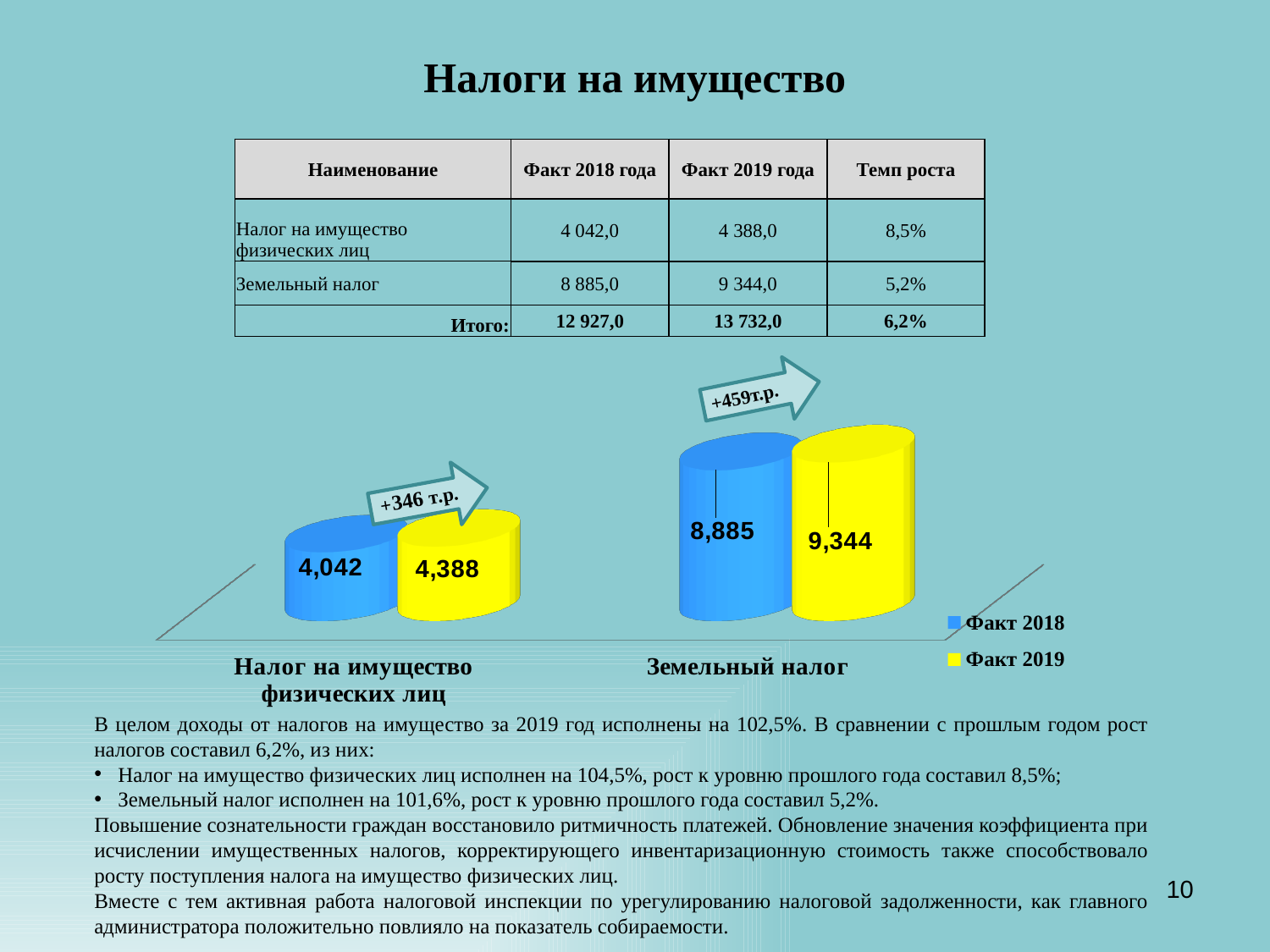
What is the difference between the Факт 2019 and Факт 2018 values for Налог на имущество физических лиц in the chart? 346 In the chart, which is larger for Земельный налог: the Факт 2018 value or the Факт 2019 value? Факт 2019 What is the value for Факт 2019 for Налог на имущество физических лиц in the chart? 4,388 What kind of chart is shown on the slide? Bar chart Which category has the highest Факт 2019 value in the chart? Земельный налог How many categories are shown on the x axis of the chart? 2 What is the value for Факт 2019 for Земельный налог in the chart? 9,344 Which category has the lowest Факт 2018 value in the chart? Налог на имущество физических лиц What is the value for Факт 2018 for Налог на имущество физических лиц in the chart? 4,042 What is the difference between the Факт 2019 and Факт 2018 values for Земельный налог in the chart? 459 What is the value for Факт 2018 for Земельный налог in the chart? 8,885 How many series does the chart legend list? 2